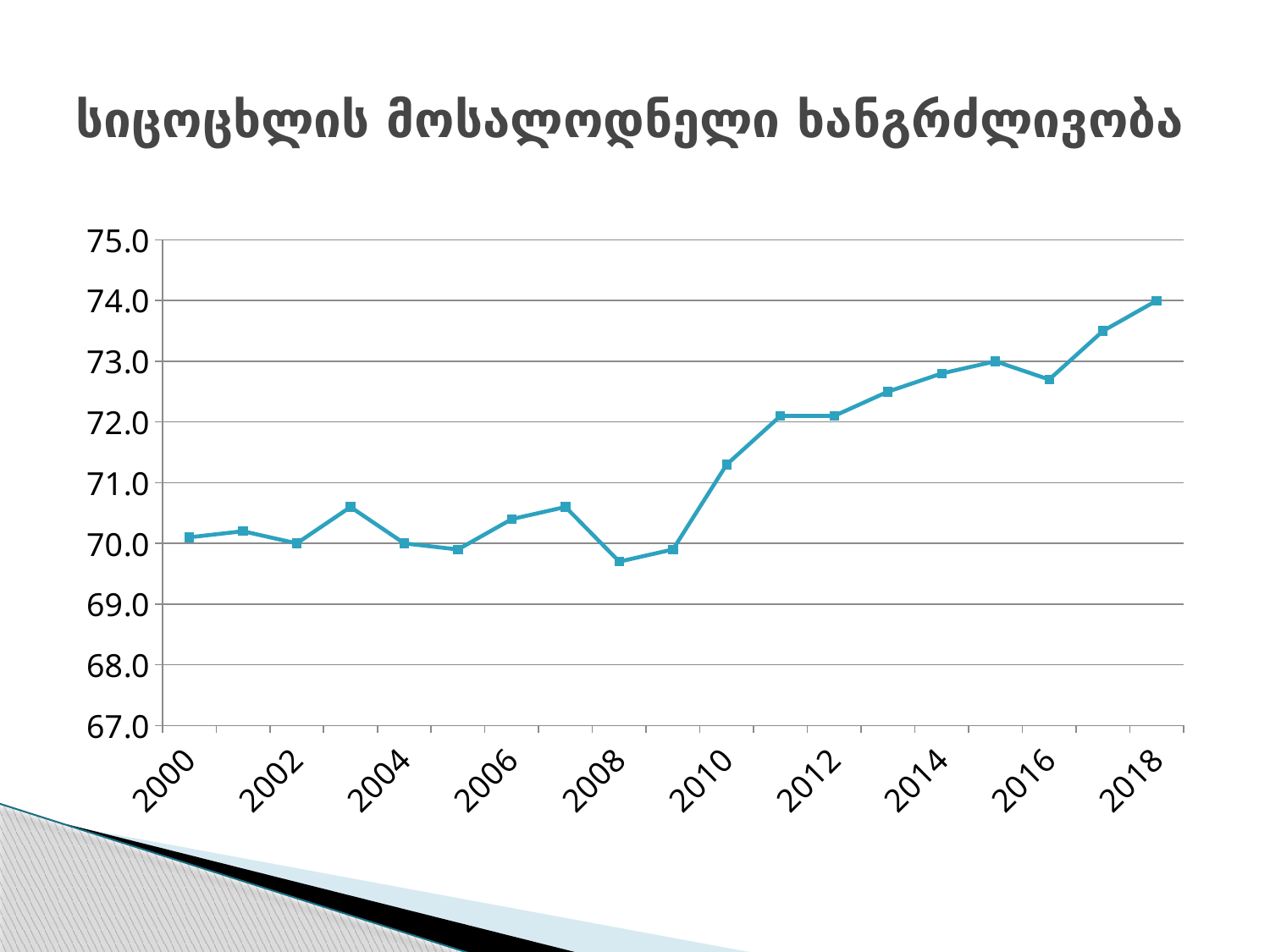
What is the value for 2015? 73.0 What kind of chart is shown on the slide? line chart What is the title of the chart? სიცოცხლის მოსალოდნელი ხანგრძლივობა Which is larger, the value for 2005 or the value for 2010? 2010 Which year has the highest value? 2018 Do the values generally rise or fall from 2000 to 2018? rise Is the value for 2010 greater or less than 71.0? greater Is the value for 2017 greater or less than 73.0? greater What is the value for 2018? 74.0 Which year has the lowest value? 2008 Is the value for 2008 greater or less than 70.0? less How many data points are plotted on the line? 19